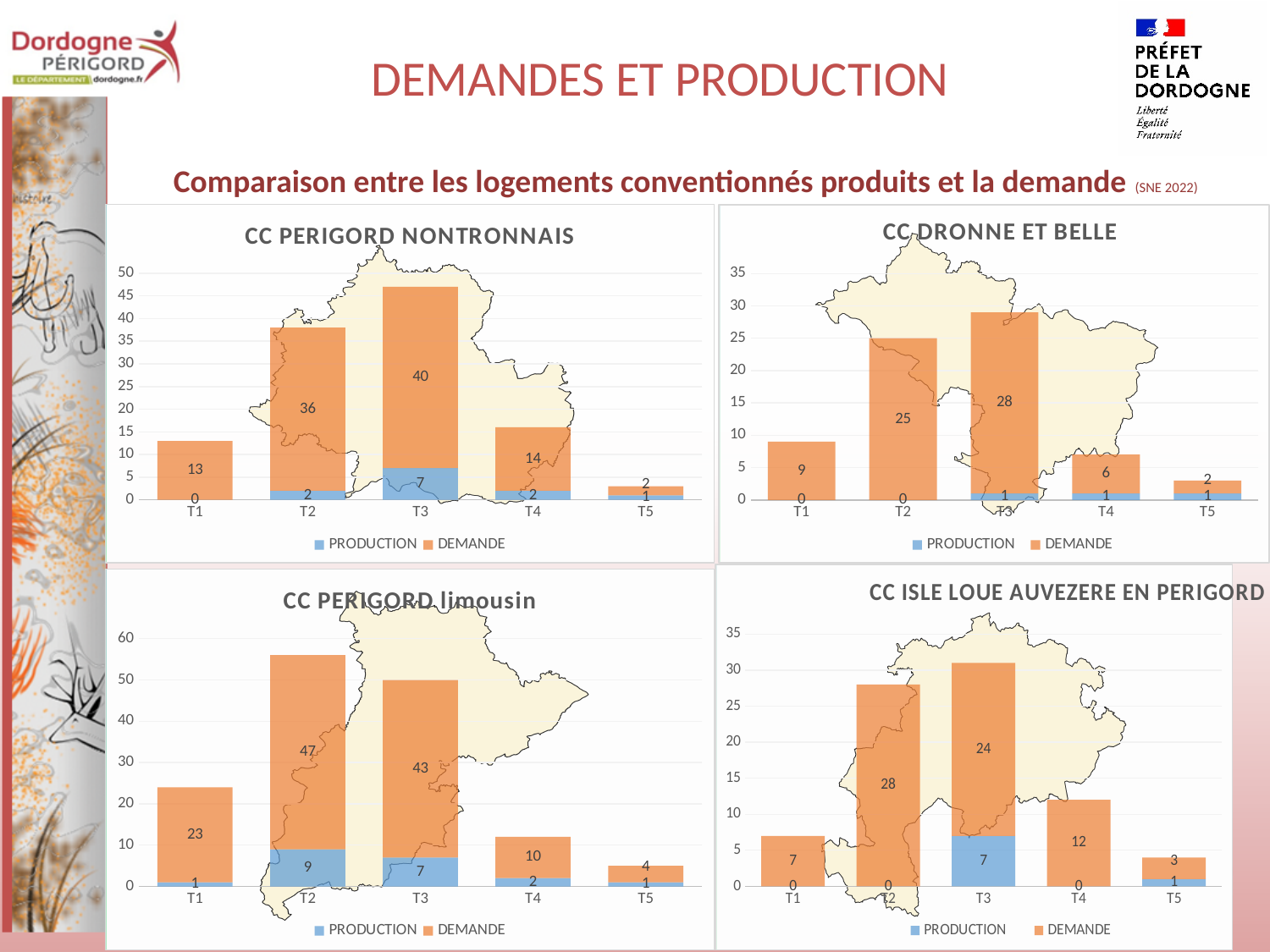
How many series does the legend of the CC DRONNE ET BELLE chart list? 2 In the CC ISLE LOUE AUVEZERE EN PERIGORD chart, which is larger, the DEMANDE value for T2 or for T3? T2 In the CC PERIGORD limousin chart, what is the difference between the DEMANDE values for T2 and T3? 4 In the CC DRONNE ET BELLE chart, what is the PRODUCTION value for T4? 1 How many categories are shown on the x axis of the CC PERIGORD NONTRONNAIS chart? 5 In the CC ISLE LOUE AUVEZERE EN PERIGORD chart, what is the DEMANDE value for T4? 12 In the CC DRONNE ET BELLE chart, which category has the highest DEMANDE value? T3 In the CC PERIGORD NONTRONNAIS chart, what is the total height of the stacked bar for T2? 38 In the CC PERIGORD limousin chart, which category has the highest PRODUCTION value? T2 What type of chart is the CC PERIGORD limousin chart? Stacked bar chart In the CC PERIGORD NONTRONNAIS chart, what is the DEMANDE value for T3? 40 In the CC ISLE LOUE AUVEZERE EN PERIGORD chart, what is the total of the stacked bar for T3? 31